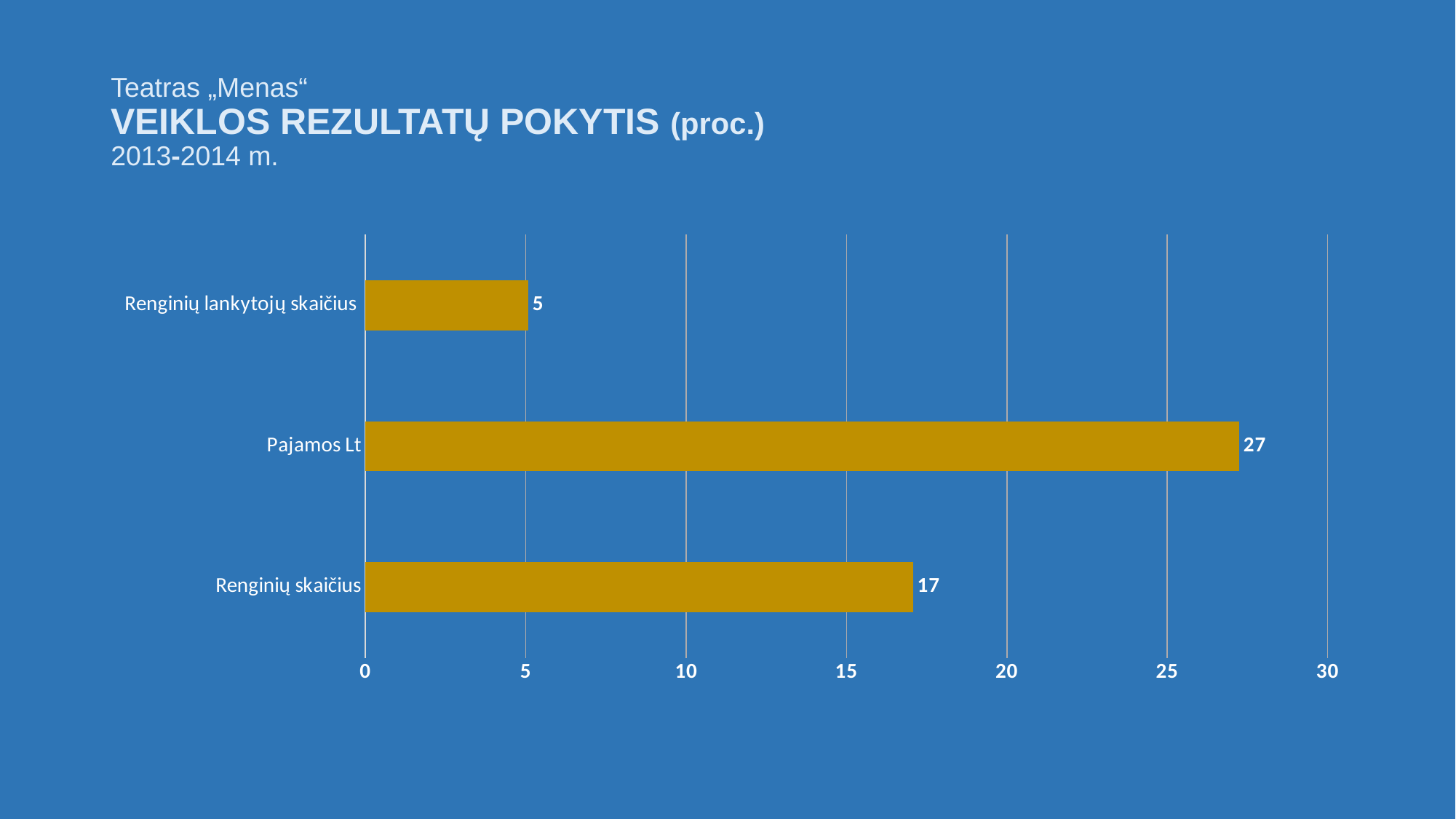
Which category has the highest value? Pajamos Lt What is the difference between the values for Pajamos Lt and Renginių skaičius? 10 Which category has the lowest value? Renginių lankytojų skaičius What is the value for Renginių lankytojų skaičius? 5 Which is larger, the value for Renginių skaičius or the value for Renginių lankytojų skaičius? Renginių skaičius What is the value for Renginių skaičius? 17 Is the value for Pajamos Lt greater or less than 25? greater What is the value for Pajamos Lt? 27 What kind of chart is shown on the slide? Bar chart What is the maximum value shown on the horizontal axis? 30 What is the difference between the values for Renginių skaičius and Renginių lankytojų skaičius? 12 How many categories are shown in the chart? 3